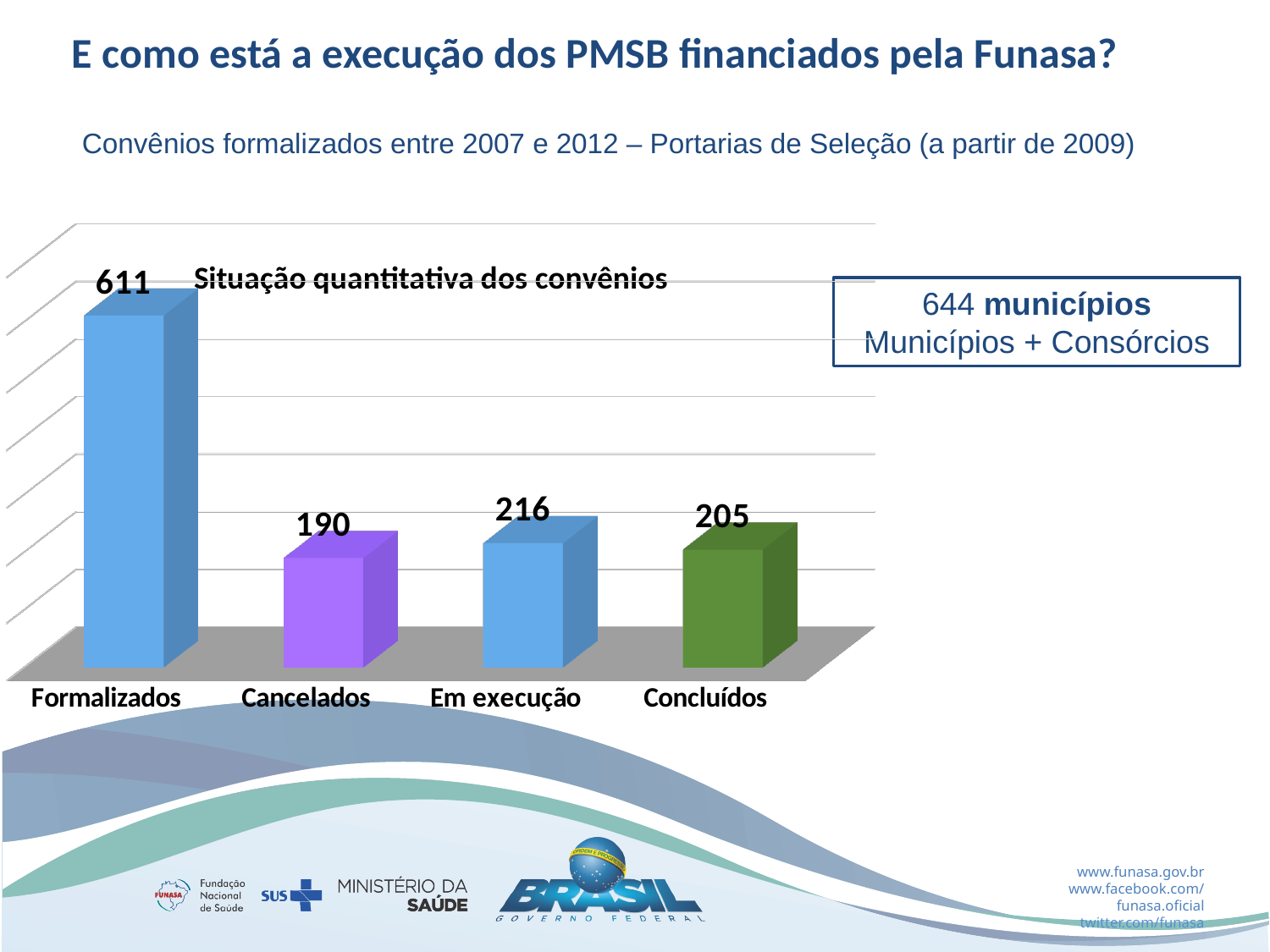
What is the value for Formalizados? 611 Which category has the highest value? Formalizados What is the title of the chart? Situação quantitativa dos convênios What is the difference between the values for Formalizados and Em execução? 395 What is the difference between the values for Em execução and Concluídos? 11 Which category has the lowest value? Cancelados What is the value for Concluídos? 205 What is the value for Em execução? 216 What kind of chart is shown on the slide? Bar chart What is the value for Cancelados? 190 Which is larger, the value for Em execução or the value for Cancelados? Em execução How many categories are shown in the chart? 4